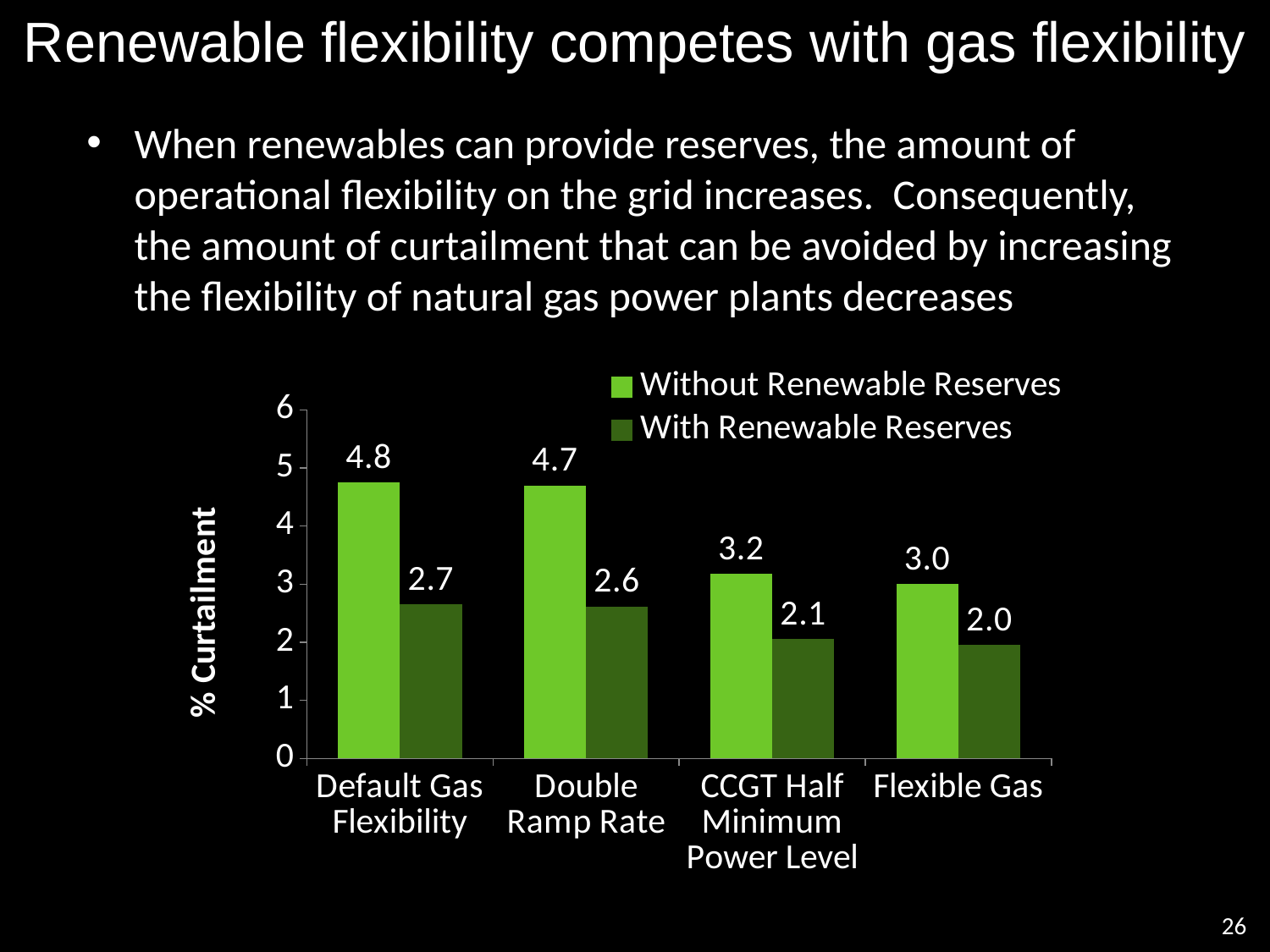
What is the % Curtailment for CCGT Half Minimum Power Level without renewable reserves? 3.2 Which is larger: the with renewable reserves value for Default Gas Flexibility or the without renewable reserves value for Flexible Gas? Flexible Gas without renewable reserves How many series does the legend list? 2 Which category has the lowest % Curtailment with renewable reserves? Flexible Gas Which category has the highest % Curtailment without renewable reserves? Default Gas Flexibility What is the % Curtailment for Default Gas Flexibility without renewable reserves? 4.8 What is the difference between the without and with renewable reserves values for Double Ramp Rate? 2.1 How many categories are shown on the x axis? 4 What is the label of the y axis? % Curtailment What kind of chart is shown on the slide? bar chart What is the % Curtailment for Flexible Gas with renewable reserves? 2.0 Is the without renewable reserves value for Double Ramp Rate greater or less than 4? greater